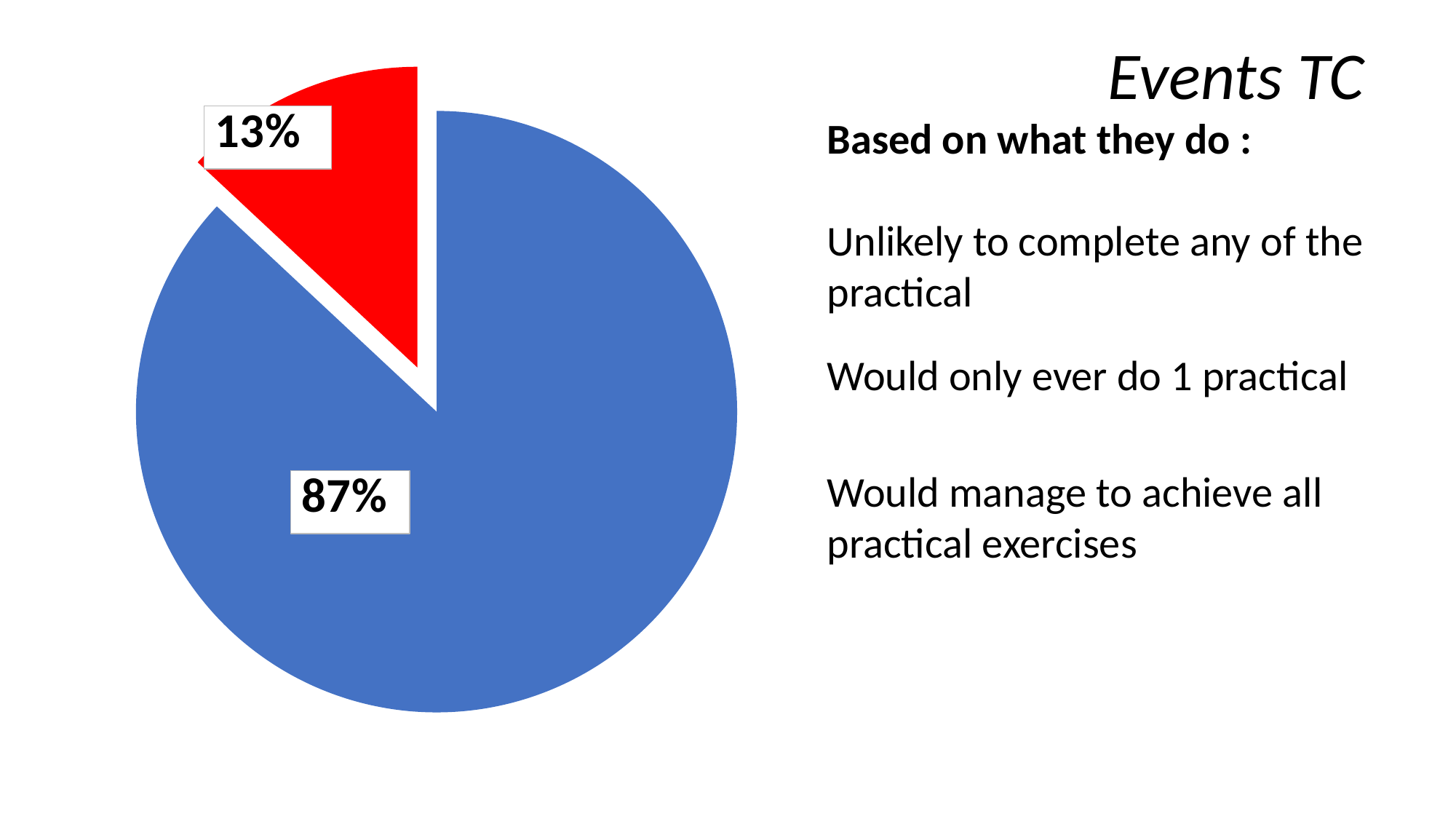
What is the title shown at the top right of the slide? Events TC What percentage is shown on the blue slice of the pie chart? 87% What colour is the slice that is pulled out from the pie? red Which is larger, the blue slice or the red slice? the blue slice Which slice of the pie chart is the smallest? the red slice (13%) What type of chart is shown on the slide? pie chart How many slices does the pie chart have? 2 Which slice of the pie chart is the largest? the blue slice (87%) What is the difference in percentage points between the blue slice and the red slice? 74 What percentage is shown on the red slice of the pie chart? 13% What share of the pie does the red slice represent? 13%